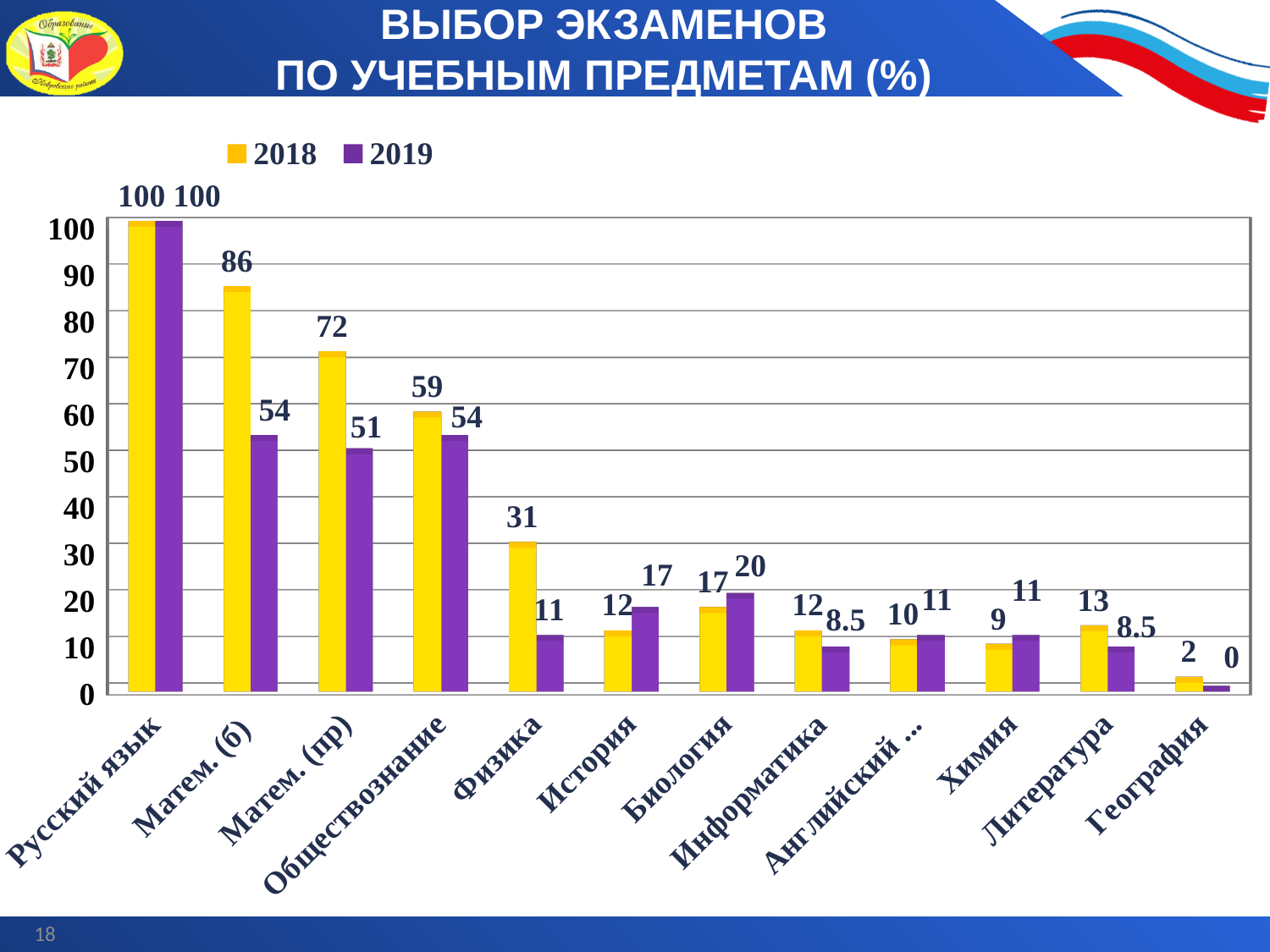
Which is larger for История: the 2018 value or the 2019 value? 2019 What kind of chart is shown on the slide? Bar chart What is the value for Физика in 2018? 31 What is the difference between the 2018 and 2019 values for Матем. (пр)? 21 Which subject has the lowest value in 2019? География Which subject has the highest value in 2018? Русский язык How many subjects are shown on the x axis? 12 What is the value for Биология in 2019? 20 What is the value for Матем. (б) in 2019? 54 Which colour represents the 2019 series? Purple How many series does the legend list? 2 What is the value for Литература in 2019? 8.5